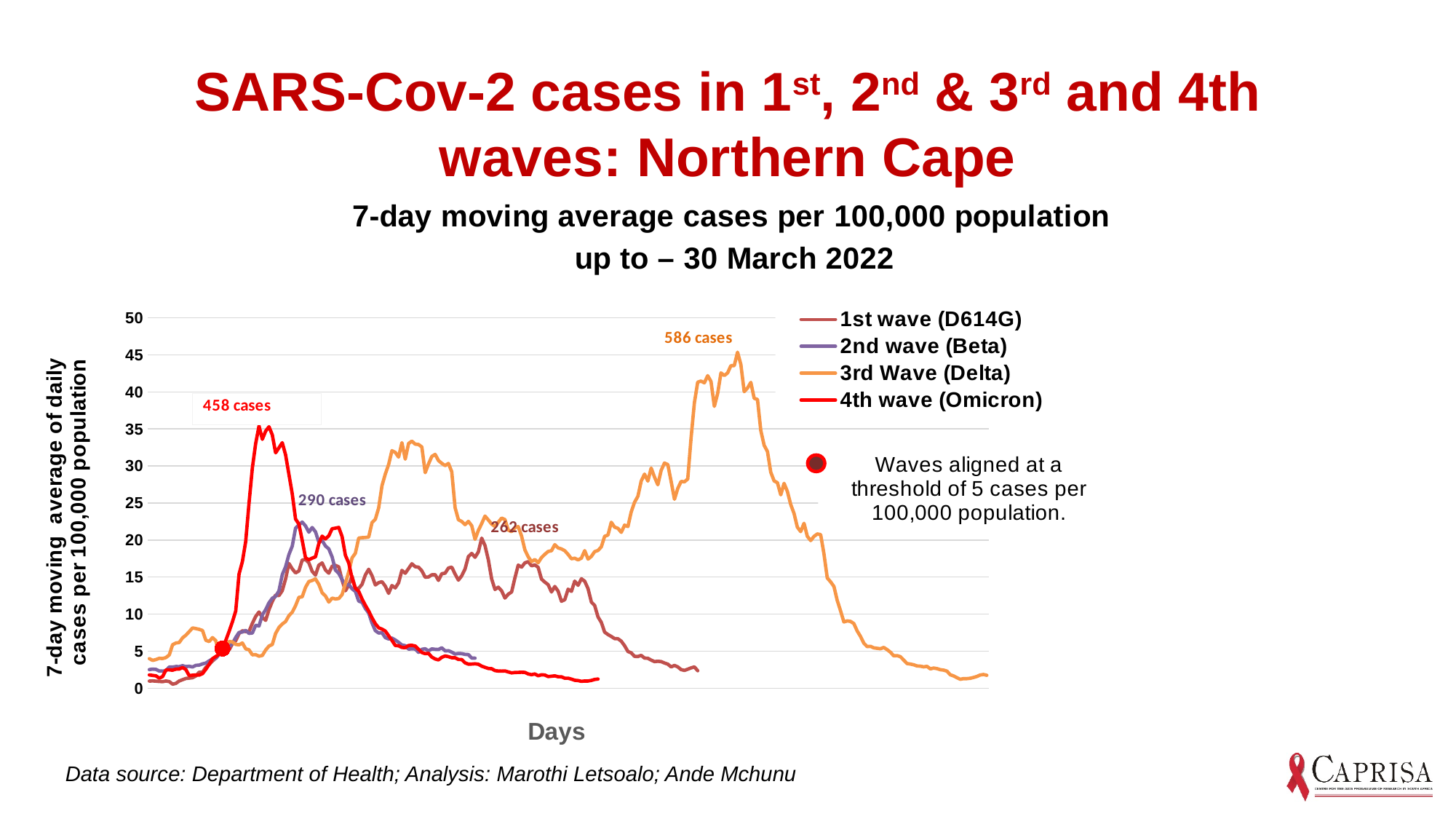
What kind of chart is shown on the slide? Line chart What is the label on the x axis of the chart? Days How many series does the legend list? 4 Which wave reaches the highest 7-day moving average of daily cases per 100,000 population? 3rd Wave (Delta) Is the peak value of the 2nd wave (Beta) greater or less than 25? less Which wave has a higher peak on the chart, the 4th wave (Omicron) or the 2nd wave (Beta)? 4th wave (Omicron) Which wave has the lowest labelled peak case count? 1st wave (D614G), 262 cases What is the difference between the labelled peak case counts of the 3rd Wave (Delta) and the 4th wave (Omicron)? 128 cases What peak case count is labelled for the 2nd wave (Beta)? 290 cases Is the peak value of the 3rd Wave (Delta) greater or less than 40? greater What peak case count is labelled for the 3rd Wave (Delta)? 586 cases What peak case count is labelled for the 4th wave (Omicron)? 458 cases